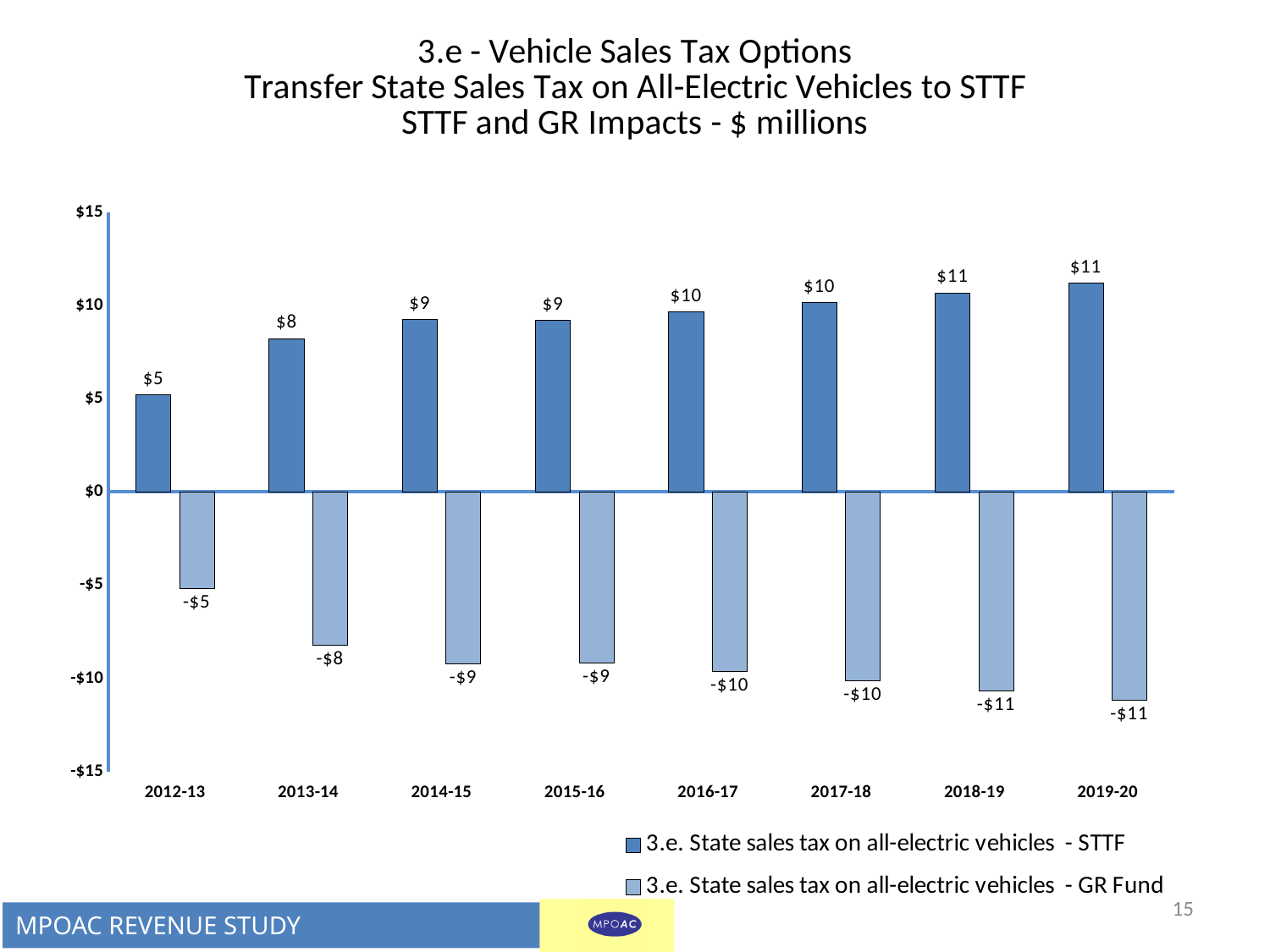
What is the STTF value for 2019-20? $11 Is the STTF value for 2018-19 greater or less than $10? greater What kind of chart is shown on the slide? Bar chart What is the GR Fund value for 2016-17? -$10 Which is larger, the STTF value for 2013-14 or for 2017-18? 2017-18 Do the STTF values rise or fall from 2012-13 to 2019-20? Rise What is the STTF value for 2012-13? $5 How many series does the legend list? 2 Which year has the lowest STTF value? 2012-13 How many fiscal years are shown on the x axis? 8 What is the difference between the STTF values for 2019-20 and 2012-13? $6 In what units are the values on the chart expressed, according to the title? $ millions